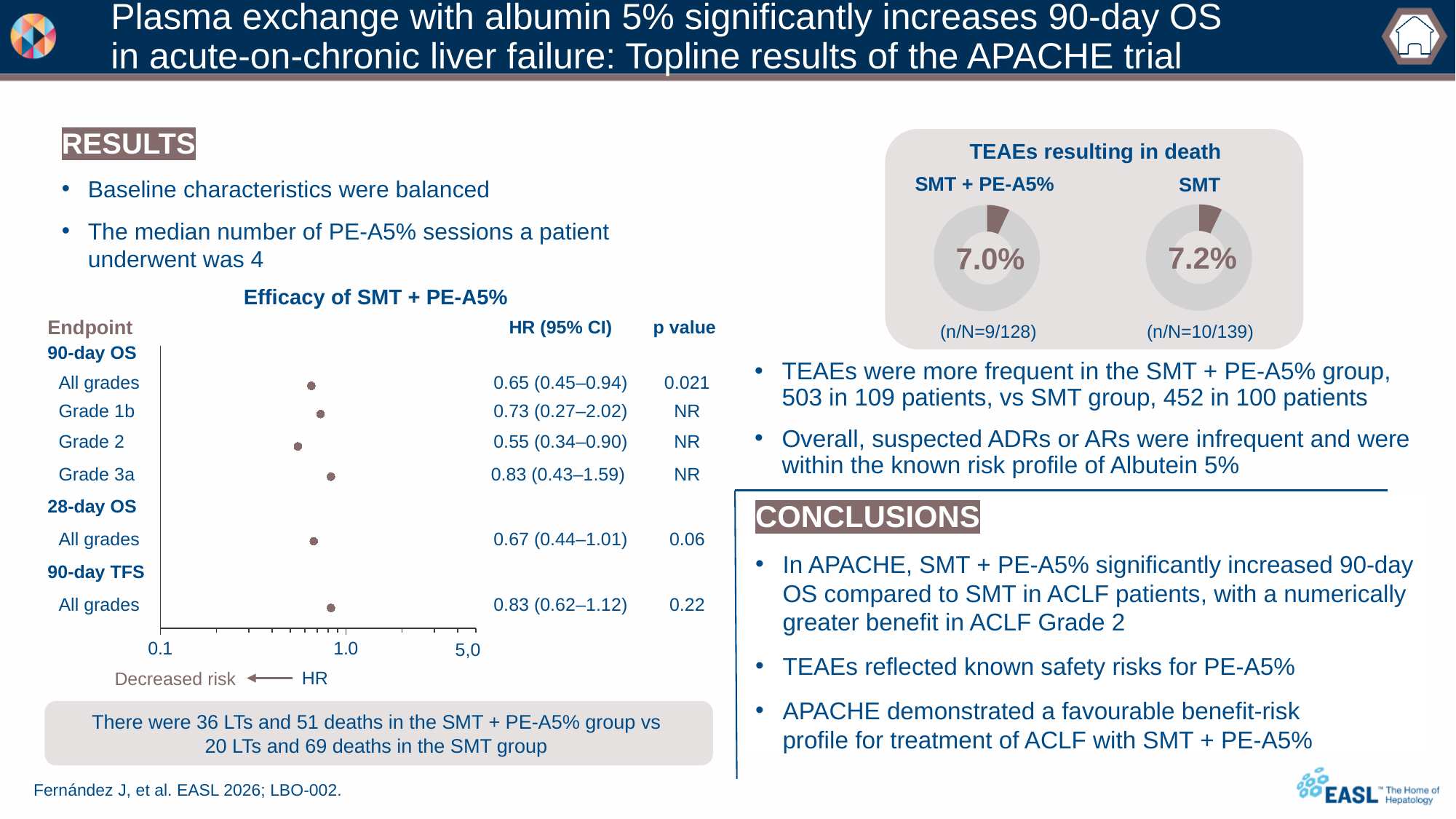
What kind of chart is the 'Efficacy of SMT + PE-A5%' chart? Forest plot In the 'TEAEs resulting in death' charts, what is the difference between the SMT percentage and the SMT + PE-A5% percentage? 0.2% In the 'TEAEs resulting in death' charts, what percentage is shown for the SMT + PE-A5% group? 7.0% In the 'Efficacy of SMT + PE-A5%' forest plot, what is the p value for 28-day OS, All grades? 0.06 In the 'Efficacy of SMT + PE-A5%' forest plot, which has the larger HR: Grade 1b or Grade 2? Grade 1b In the 'Efficacy of SMT + PE-A5%' forest plot, is the HR for 90-day TFS All grades greater or less than 1.0? less In the 'Efficacy of SMT + PE-A5%' forest plot, what is the difference between the HR for 90-day OS All grades and the HR for 90-day OS Grade 2? 0.10 How many hazard ratio points are plotted in the 'Efficacy of SMT + PE-A5%' forest plot? 6 In the 'TEAEs resulting in death' charts, which group has the higher percentage: SMT + PE-A5% or SMT? SMT In the 'Efficacy of SMT + PE-A5%' forest plot, what is the HR (95% CI) for 90-day OS, All grades? 0.65 (0.45–0.94) In the 'Efficacy of SMT + PE-A5%' forest plot, which endpoint row has the lowest hazard ratio? Grade 2 (90-day OS) What kind of charts are used to show 'TEAEs resulting in death'? Donut (pie) charts